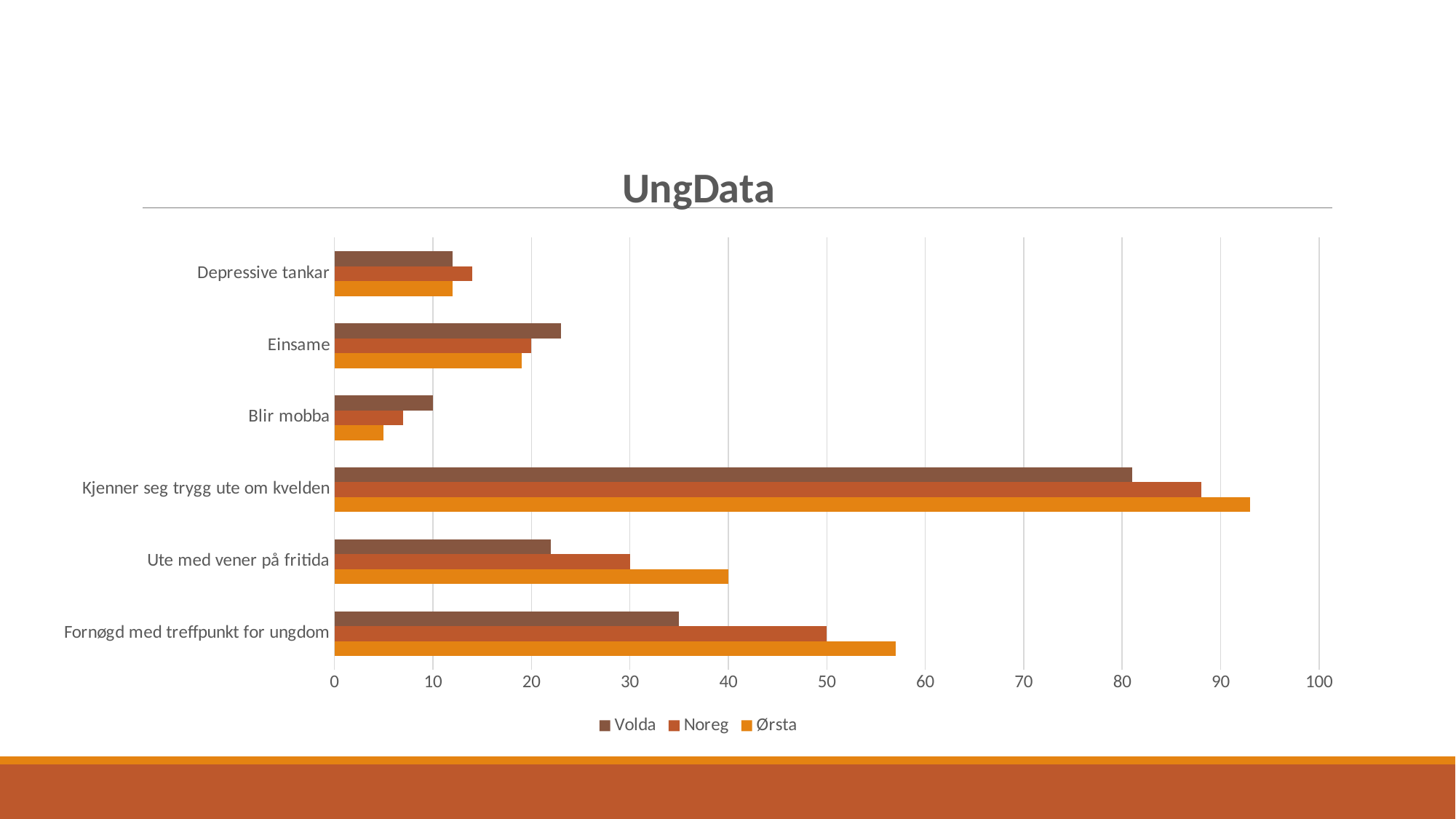
What kind of chart is shown on the slide? bar chart In the category 'Ute med vener på fritida', which is larger, the value for Volda or the value for Ørsta? Ørsta What is the title of the chart? UngData Which series has the lowest value in the category 'Blir mobba'? Ørsta How many series does the legend list? 3 Is the value for Ørsta in 'Kjenner seg trygg ute om kvelden' greater or less than 90? greater What is the value for Ørsta in the category 'Ute med vener på fritida'? 40 Which category has the highest values across all three series? Kjenner seg trygg ute om kvelden What is the value for Volda in the category 'Blir mobba'? 10 Is the value for Volda in 'Fornøgd med treffpunkt for ungdom' greater or less than 40? less What is the value for Noreg in the category 'Fornøgd med treffpunkt for ungdom'? 50 How many categories are shown on the chart? 6